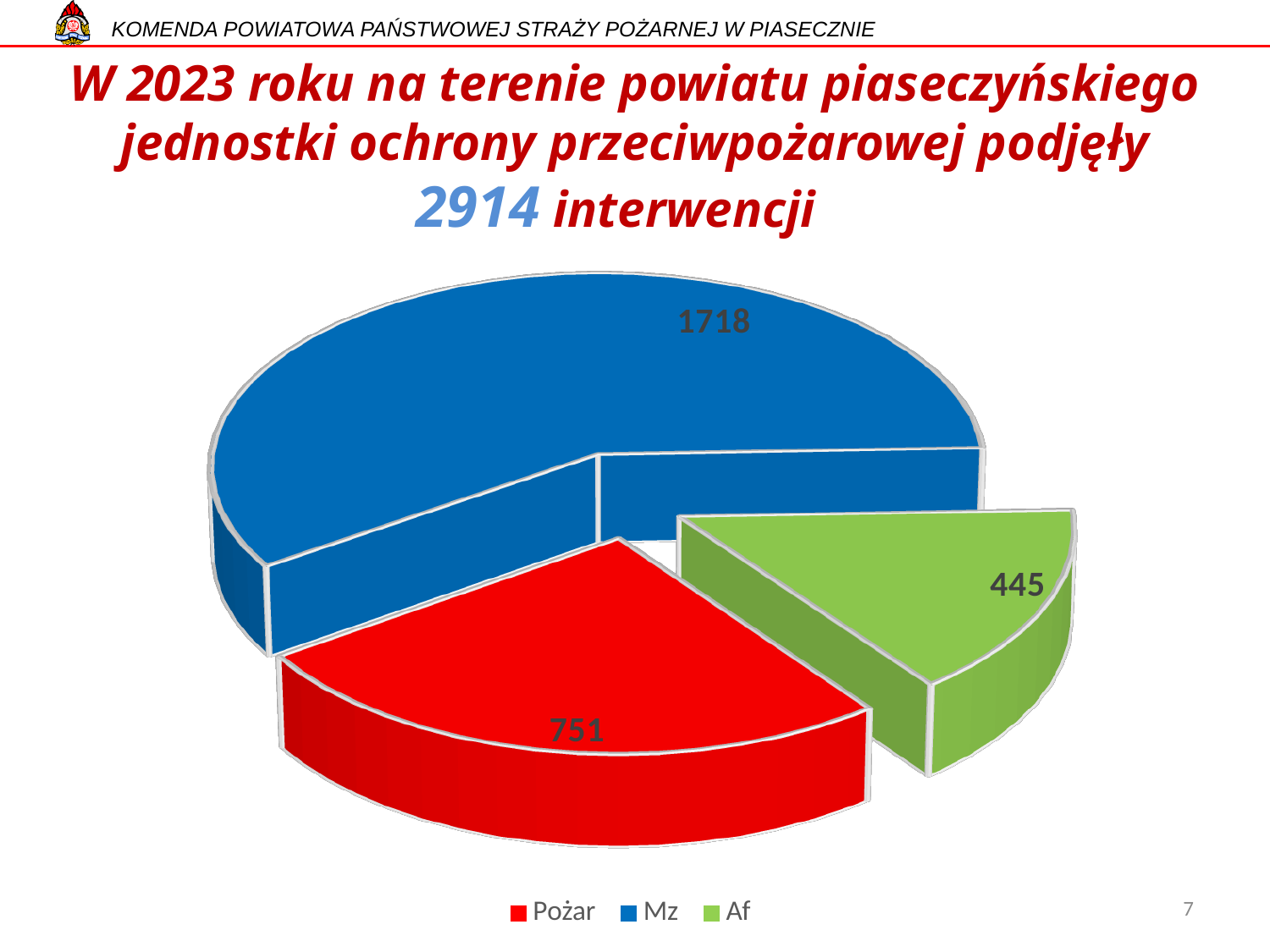
What is the difference between the Mz value and the Pożar value? 967 What is the value for the Mz slice? 1718 What is the value for the Pożar slice? 751 How many entries does the legend list? 3 Which category has the smallest slice of the pie? Af What is the difference between the Pożar value and the Af value? 306 Which category has the largest slice of the pie? Mz What is the value for the Af slice? 445 What colour is the Af slice in the pie chart? green Which is larger, the value for Pożar or the value for Af? Pożar How many slices does the pie chart have? 3 What type of chart is shown on the slide? pie chart